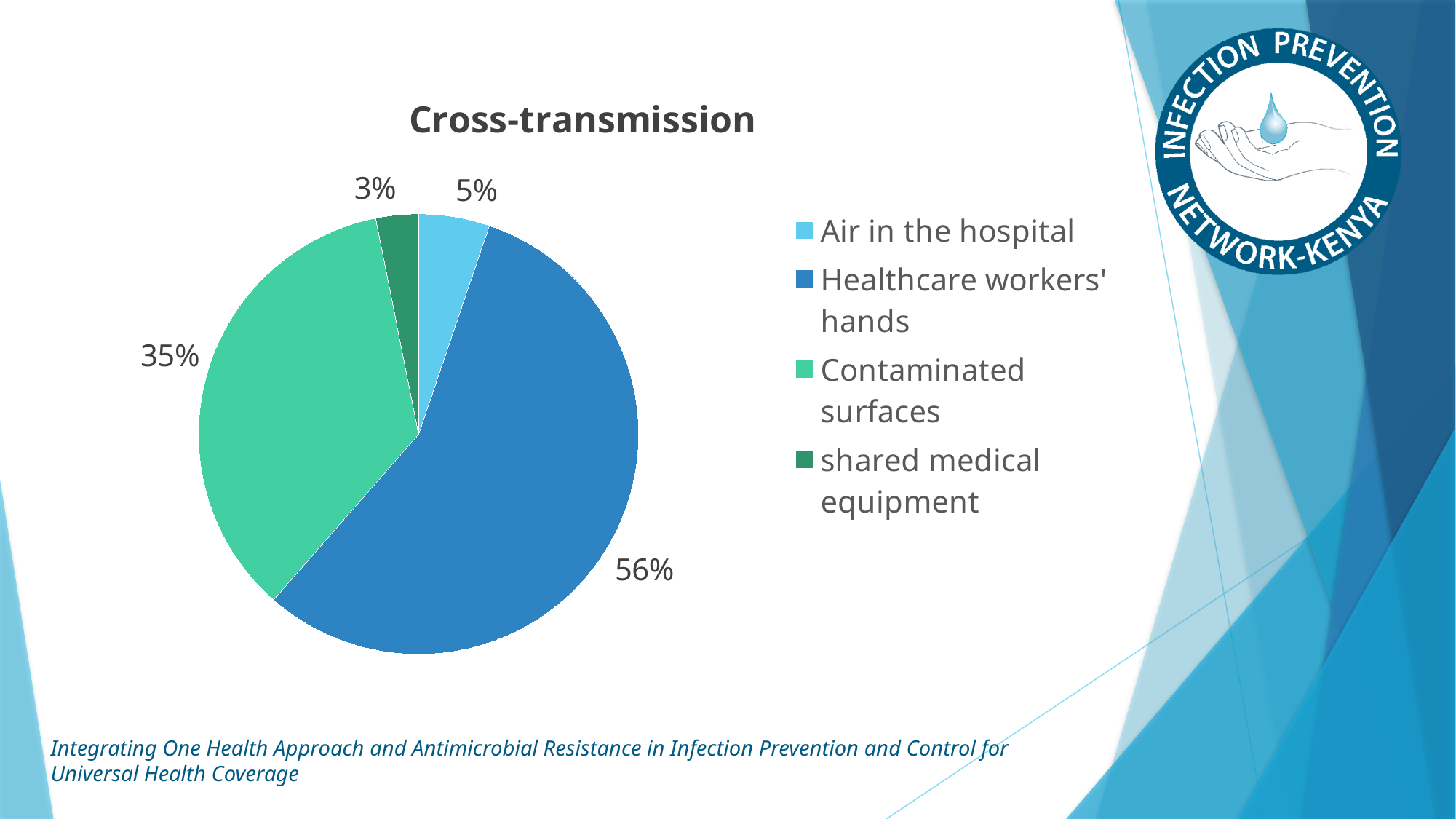
What is the difference between the shares for Healthcare workers' hands and Contaminated surfaces? 21% What percentage of the pie is Healthcare workers' hands? 56% What percentage of the pie is Air in the hospital? 5% Which is larger, the share for Air in the hospital or the share for shared medical equipment? Air in the hospital What is the title of the chart? Cross-transmission What kind of chart is shown on the slide? pie chart Which category has the smallest share of the pie? shared medical equipment How many categories does the legend list? 4 What percentage of the pie is Contaminated surfaces? 35% Which category has the largest share of the pie? Healthcare workers' hands What colour is the slice for Contaminated surfaces? green What percentage of the pie is shared medical equipment? 3%